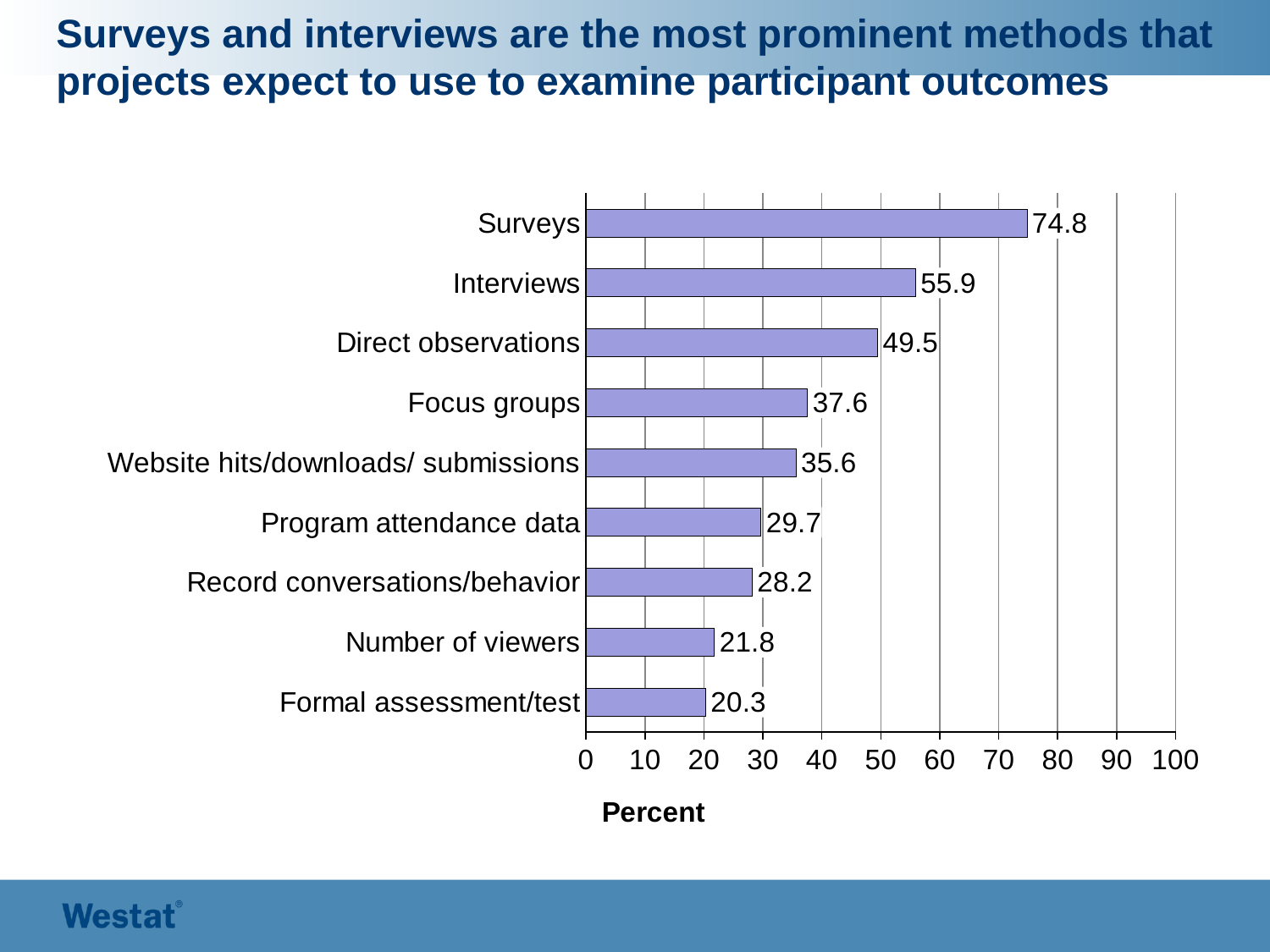
Which category has the highest value? Surveys What is the value for Program attendance data? 29.7 Which category has the lowest value? Formal assessment/test What is the value for Direct observations? 49.5 What is the difference between the values for Focus groups and Website hits/downloads/ submissions? 2.0 How many categories are shown in the chart? 9 What kind of chart is shown on the slide? bar chart What is the difference between the values for Surveys and Interviews? 18.9 Is the value for Interviews greater or less than 50? greater Which is larger, the value for Number of viewers or the value for Record conversations/behavior? Record conversations/behavior What is the label on the horizontal axis of the chart? Percent What is the value for Surveys? 74.8